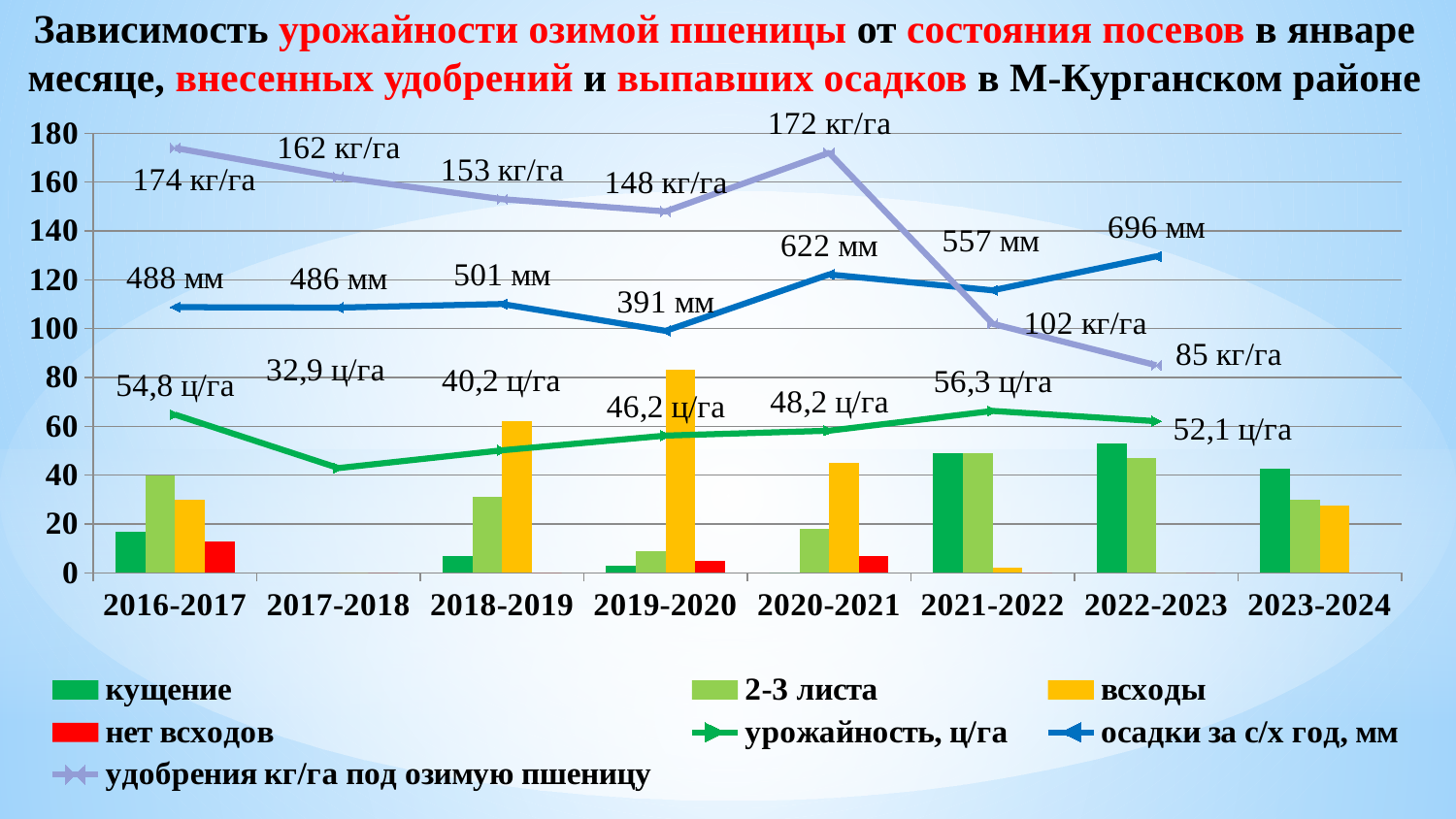
What is the difference between the precipitation values for 2020-2021 and 2019-2020? 231 мм What is the precipitation (осадки за с/х год) value shown for 2019-2020? 391 мм What kind of chart is shown on the slide? Combined bar and line chart Is the value of the всходы bar for 2019-2020 greater or less than 60? greater What is the fertilizer (удобрения) value shown for 2016-2017? 174 кг/га How many seasons are shown on the x axis? 8 By how much does the fertilizer value for 2016-2017 exceed the value for 2022-2023? 89 кг/га What is the yield (урожайность) value shown for 2021-2022? 56,3 ц/га Which season has the higher yield (урожайность): 2016-2017 or 2022-2023? 2016-2017 In which season is the yield (урожайность) value the lowest? 2017-2018 In which season is the precipitation (осадки за с/х год) value the highest? 2022-2023 How many series does the legend list? 7